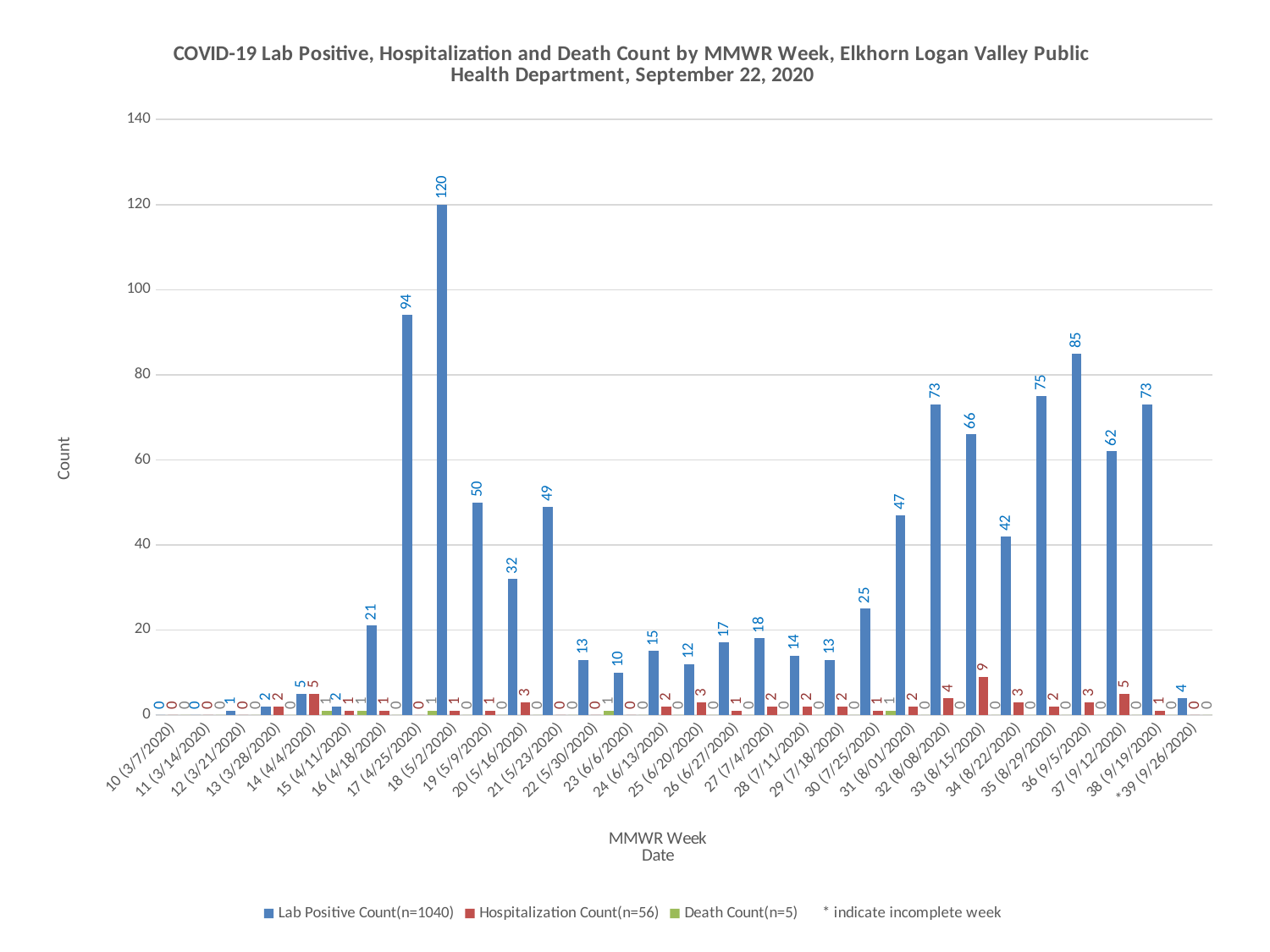
Which MMWR week has the highest Lab Positive Count? 18 (5/2/2020) How many series does the legend list? 3 What is the difference in Lab Positive Count between week 36 (9/5/2020) and week 35 (8/29/2020)? 10 Which has a larger Lab Positive Count, week 17 (4/25/2020) or week 36 (9/5/2020)? 17 (4/25/2020) How many MMWR weeks are shown on the x axis? 30 Does the Lab Positive Count rise or fall from week 18 (5/2/2020) to week 23 (6/6/2020)? Fall What is the Hospitalization Count for MMWR week 37 (9/12/2020)? 5 What kind of chart is shown on the slide? Bar chart What is the Lab Positive Count for MMWR week 18 (5/2/2020)? 120 According to the legend, what is the total n for Lab Positive Count? 1040 What is the Hospitalization Count for MMWR week 33 (8/15/2020)? 9 Which MMWR week has the highest Hospitalization Count? 33 (8/15/2020)